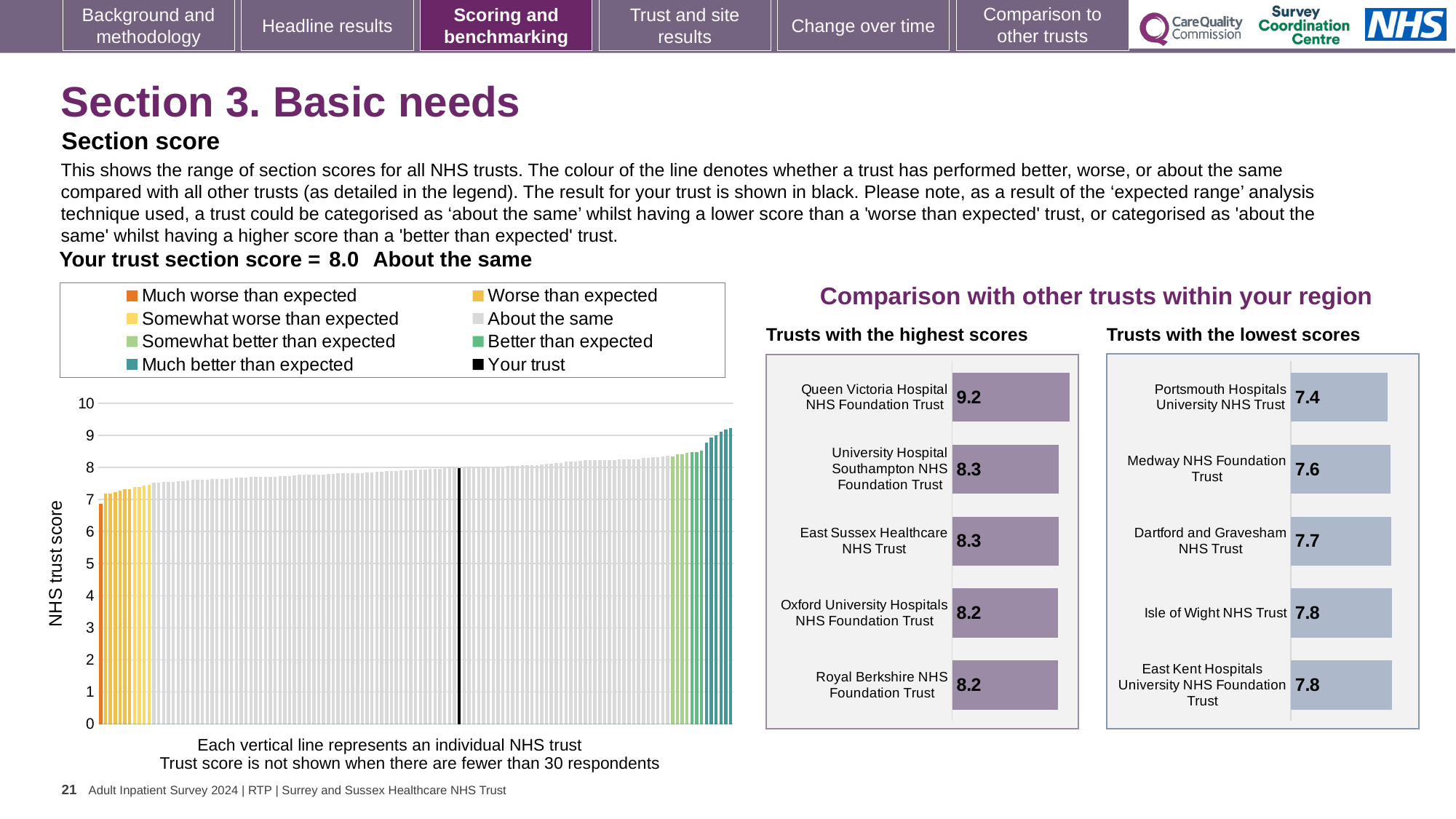
In the 'Trusts with the lowest scores' chart, what is the score for Portsmouth Hospitals University NHS Trust? 7.4 In the 'Trusts with the highest scores' chart, what is the score for Queen Victoria Hospital NHS Foundation Trust? 9.2 How many trusts are shown in the 'Trusts with the highest scores' chart? 5 In the 'Trusts with the highest scores' chart, which trust has the highest score? Queen Victoria Hospital NHS Foundation Trust In the 'Trusts with the lowest scores' chart, which trust has the lowest score? Portsmouth Hospitals University NHS Trust In the large chart on the left showing NHS trust scores, do the values rise or fall from left to right? Rise In the 'Trusts with the lowest scores' chart, how much higher is the score for Isle of Wight NHS Trust than for Portsmouth Hospitals University NHS Trust? 0.4 In the 'Trusts with the highest scores' chart, what is the difference between the scores of Queen Victoria Hospital NHS Foundation Trust and Royal Berkshire NHS Foundation Trust? 1.0 What type of chart is the large chart on the left showing NHS trust scores? Bar chart In the 'Trusts with the lowest scores' chart, which has the higher score: Medway NHS Foundation Trust or Dartford and Gravesham NHS Trust? Dartford and Gravesham NHS Trust How many entries does the legend of the large chart on the left list? 8 In the 'Trusts with the lowest scores' chart, what is the score for Dartford and Gravesham NHS Trust? 7.7